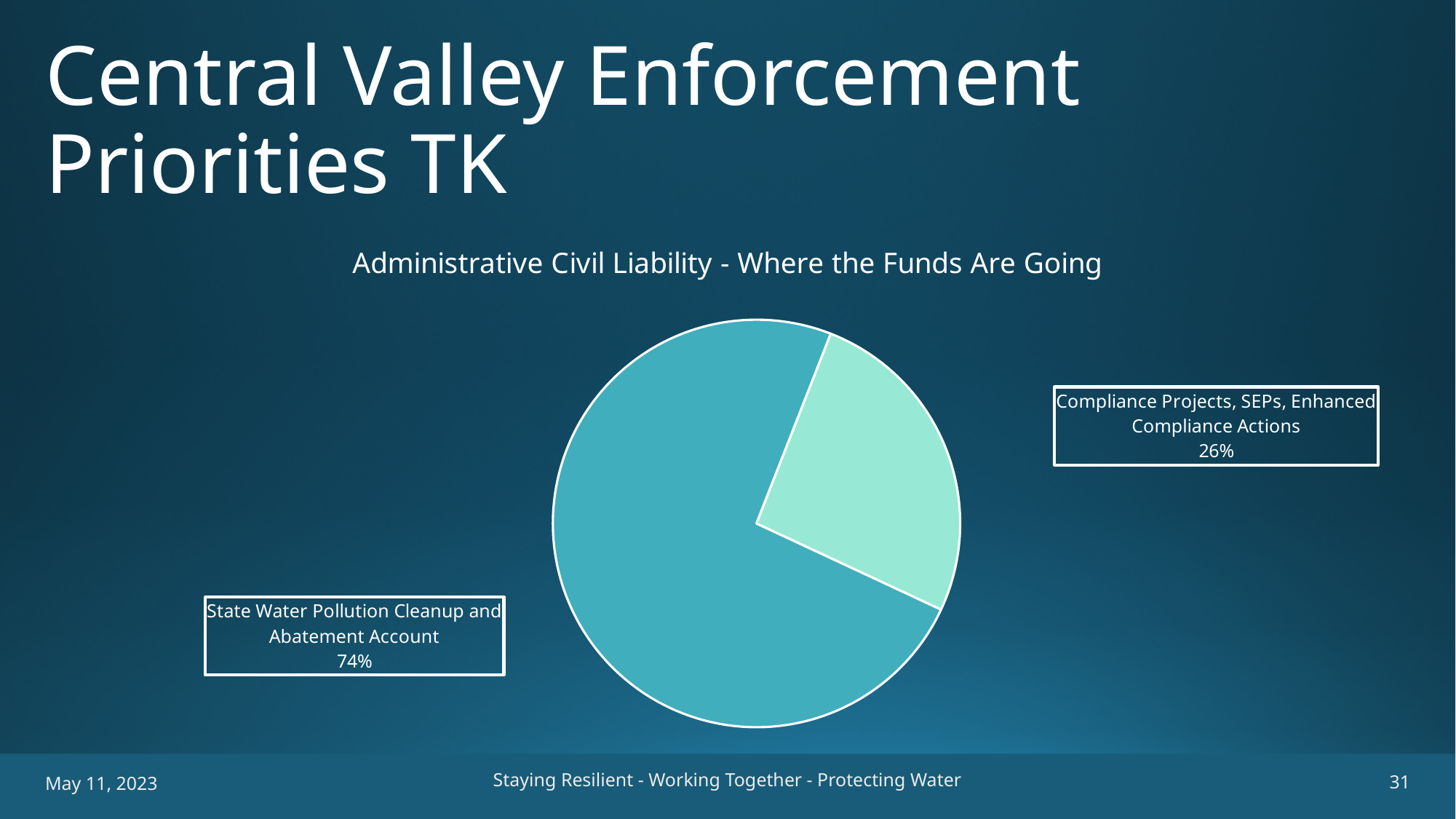
Which is larger: the share for the State Water Pollution Cleanup and Abatement Account or the share for Compliance Projects, SEPs, Enhanced Compliance Actions? State Water Pollution Cleanup and Abatement Account Which slice of the pie is the smallest? Compliance Projects, SEPs, Enhanced Compliance Actions Which slice is shown in the lighter colour? Compliance Projects, SEPs, Enhanced Compliance Actions What share of the pie goes to Compliance Projects, SEPs, Enhanced Compliance Actions? 26% Is the share for Compliance Projects, SEPs, Enhanced Compliance Actions greater or less than 50%? less Which slice of the pie is the largest? State Water Pollution Cleanup and Abatement Account What share of the pie goes to the State Water Pollution Cleanup and Abatement Account? 74% What is the difference in percentage points between the State Water Pollution Cleanup and Abatement Account slice and the Compliance Projects, SEPs, Enhanced Compliance Actions slice? 48 percentage points How many slices does the pie chart have? 2 What type of chart is shown on the slide? pie chart What is the title of the chart? Administrative Civil Liability - Where the Funds Are Going